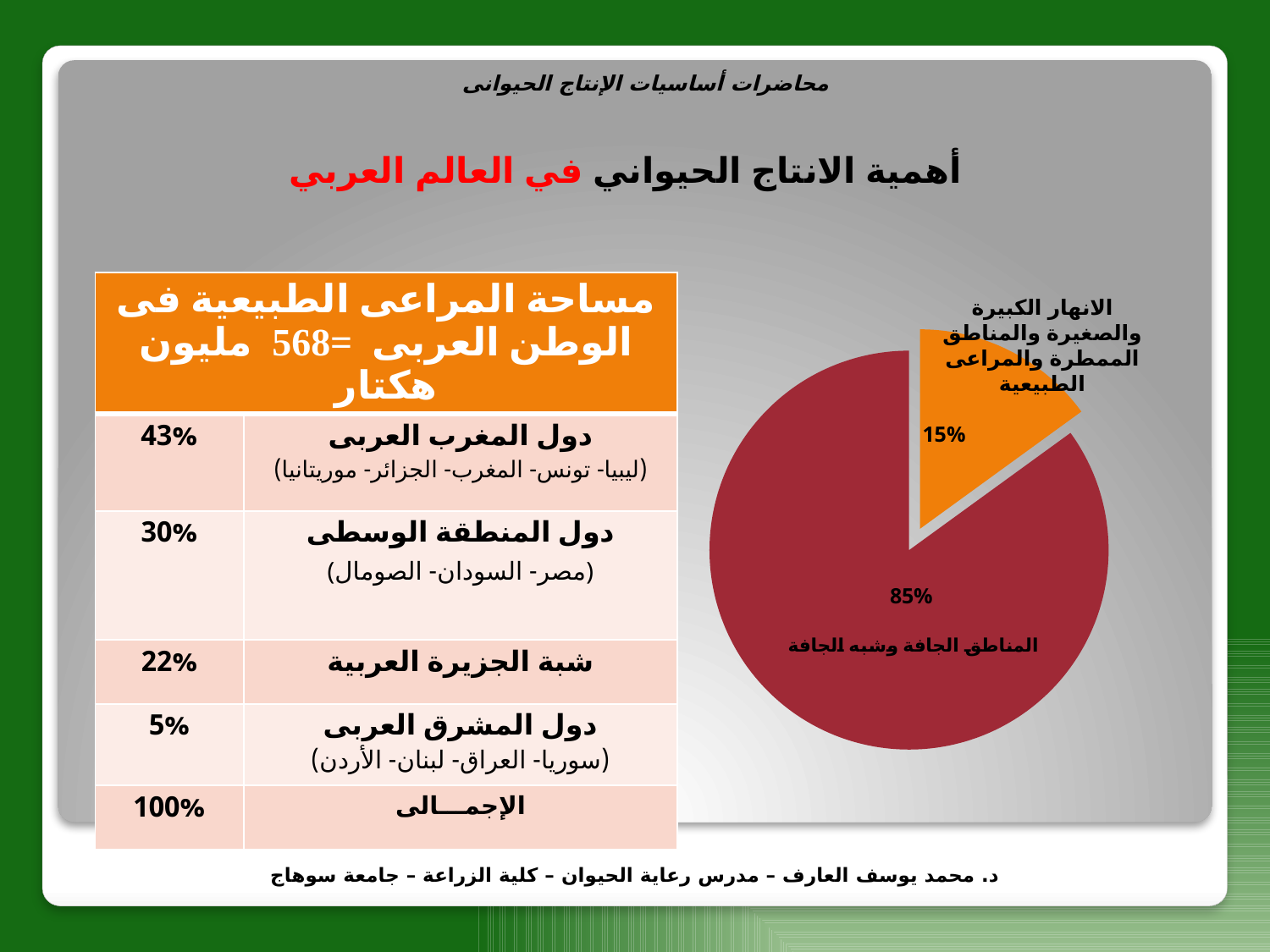
What share of the pie chart is labelled الانهار الكبيرة والصغيرة والمناطق الممطرة والمراعى الطبيعية? 15% Which slice of the pie chart is the smallest? الانهار الكبيرة والصغيرة والمناطق الممطرة والمراعى الطبيعية Which is larger in the pie chart: the slice for المناطق الجافة وشبه الجافة or the slice for الانهار الكبيرة والصغيرة والمناطق الممطرة والمراعى الطبيعية? المناطق الجافة وشبه الجافة How many slices does the pie chart have? 2 What is the total of the two percentages shown on the pie chart? 100% What is the difference in percentage points between the two slices of the pie chart? 70 Which slice of the pie chart is the largest? المناطق الجافة وشبه الجافة What share of the pie chart is labelled المناطق الجافة وشبه الجافة? 85% What colour is the 15% slice of the pie chart? Orange What kind of chart is shown on the slide? Pie chart What colour is the 85% slice of the pie chart? Dark red